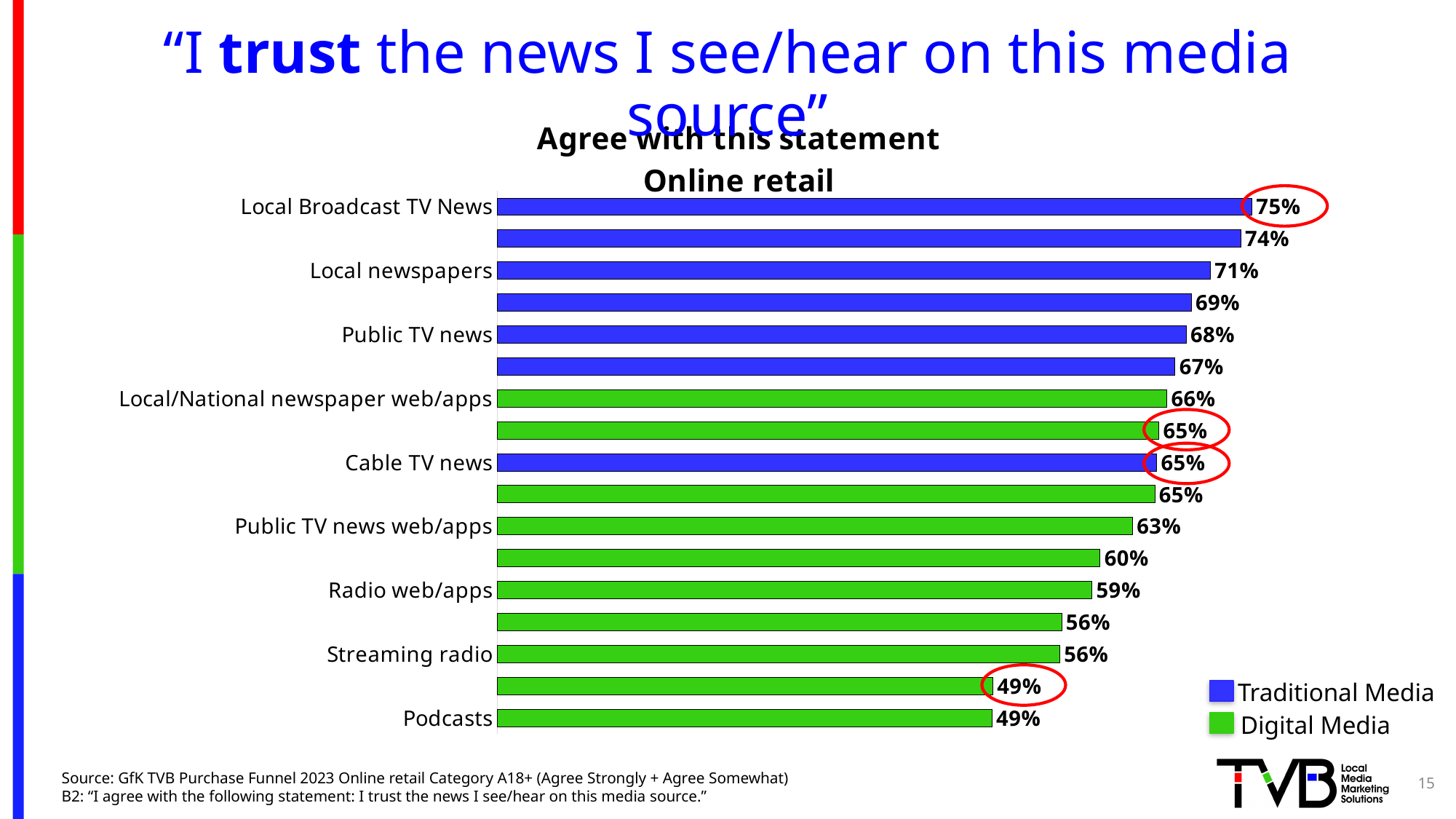
How many bars are plotted on the chart? 17 What colour represents Digital Media in the legend? Green What is the difference in percentage points between Local Broadcast TV News and Podcasts? 26 percentage points How many series does the legend list? 2 What percentage agree with the statement for Local Broadcast TV News? 75% What percentage is shown for Cable TV news? 65% Which media source has the highest percentage agreeing with the statement? Local Broadcast TV News What kind of chart is shown on the slide? Bar chart Which has a higher value, Local newspapers or Cable TV news? Local newspapers What is the lowest percentage value shown on the chart? 49% What is the value for Local/National newspaper web/apps? 66% What is the value shown for Podcasts? 49%